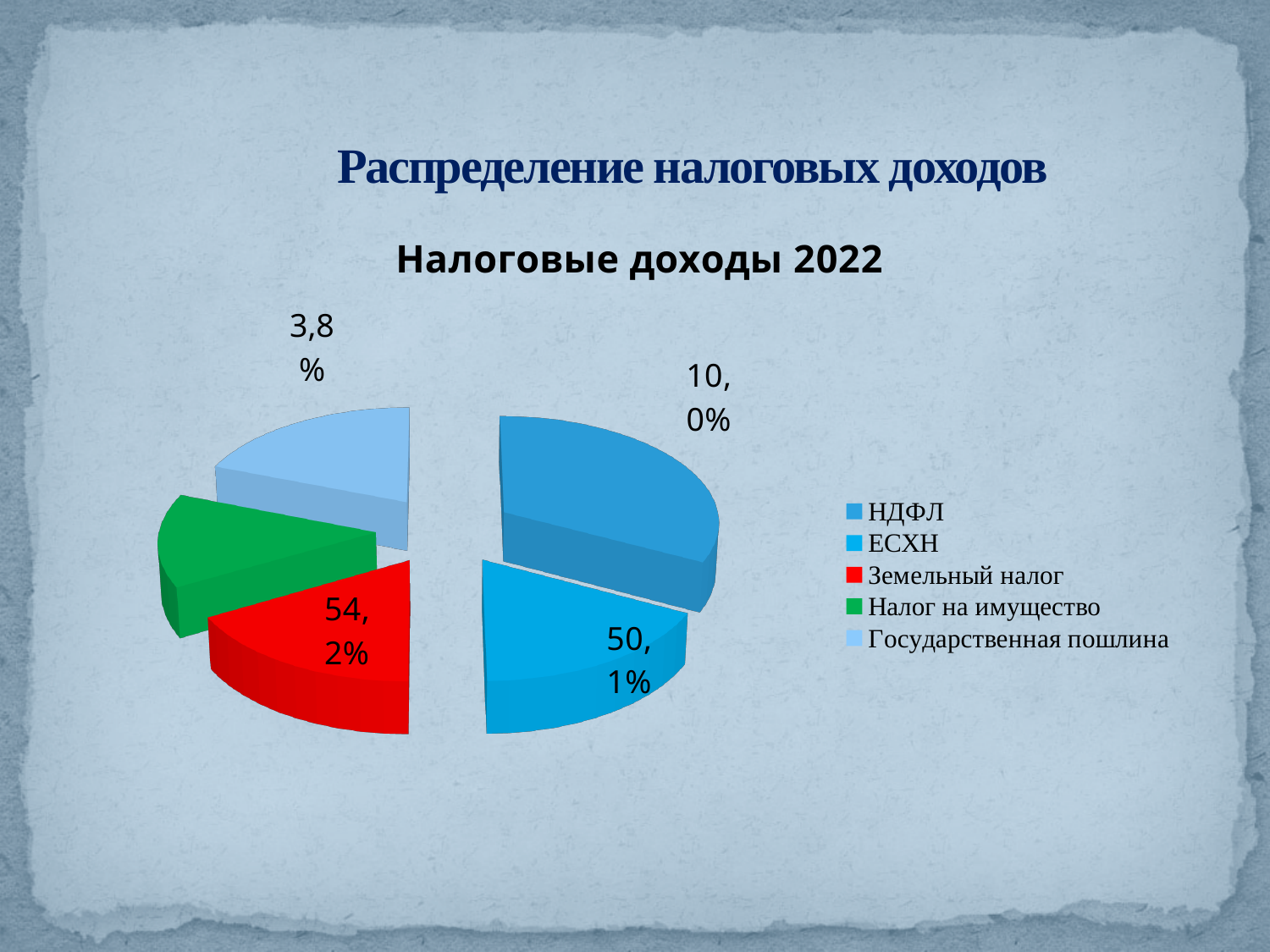
What is the difference between the labelled values for Земельный налог and ЕСХН? 4,1% What value is labelled on the Государственная пошлина slice? 3,8% What value is labelled on the Земельный налог slice? 54,2% What value is labelled on the ЕСХН slice? 50,1% How many categories does the legend of the pie chart list? 5 Which labelled slice has the largest value? Земельный налог What value is labelled on the НДФЛ slice? 10,0% What type of chart is shown on the slide? pie chart Which labelled slice has the smallest value? Государственная пошлина What colour is the Налог на имущество slice? green Which has the larger labelled value, НДФЛ or Государственная пошлина? НДФЛ What is the title of the chart? Налоговые доходы 2022